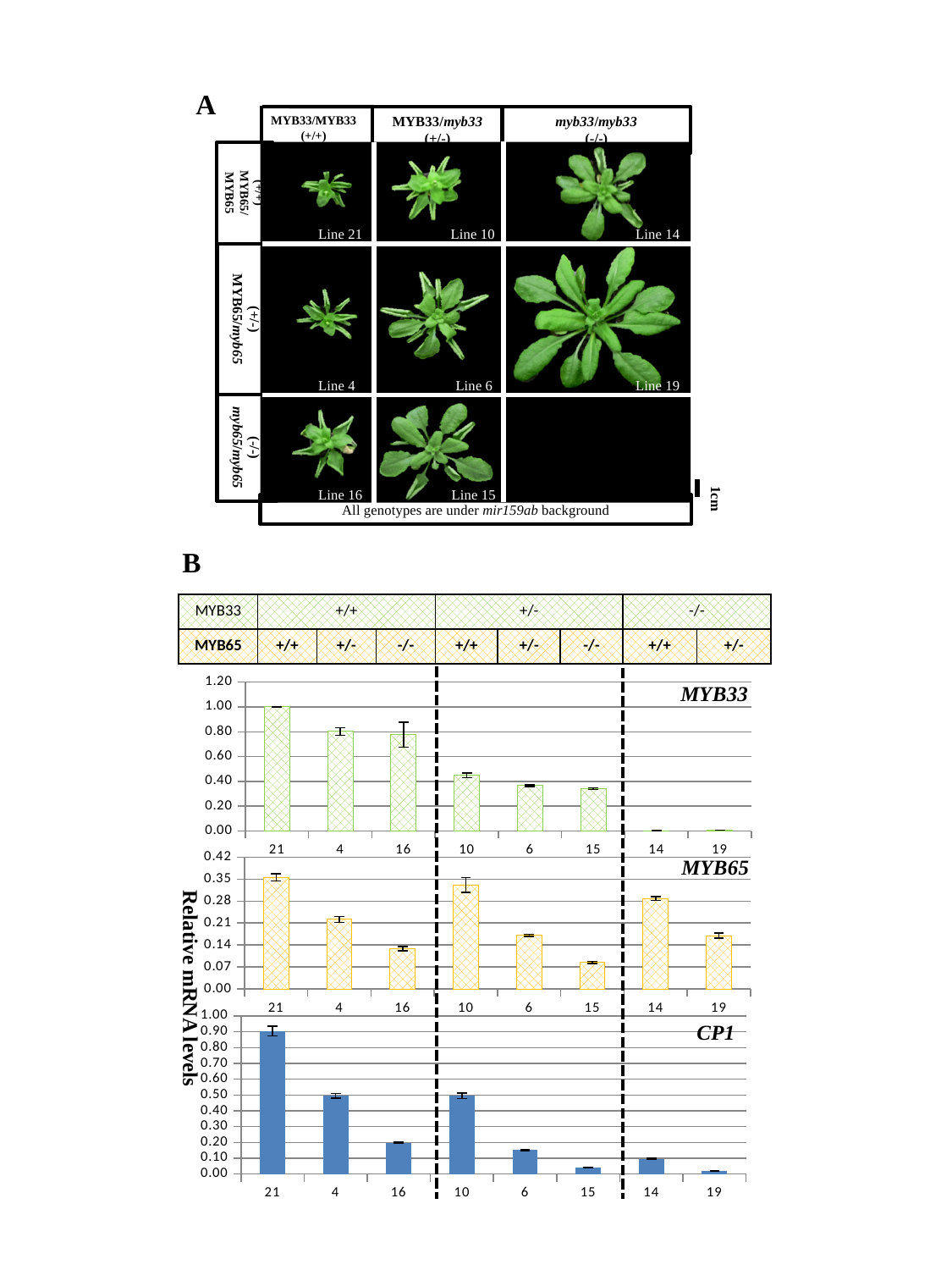
In the MYB65 chart, which line has the lowest relative mRNA level? 15 In the MYB33 chart, what is the relative mRNA level for line 21? 1.00 What is the y-axis label shared by the three charts in panel B? Relative mRNA levels How many lines (categories) are plotted along the x axis of the CP1 chart? 8 In the MYB33 chart, which line has the highest relative mRNA level? 21 In the MYB65 chart, is the value for line 21 greater or less than 0.28? greater In the MYB65 chart, which is larger, the value for line 4 or the value for line 16? line 4 What kind of chart is the MYB33 chart in panel B? bar chart In the CP1 chart, which line has the highest relative mRNA level? 21 In the MYB33 chart, is the value for line 10 greater or less than 0.60? less In the CP1 chart, do the values rise or fall going from line 21 to line 4 to line 16? fall In the CP1 chart, is the value for line 21 greater or less than 0.80? greater